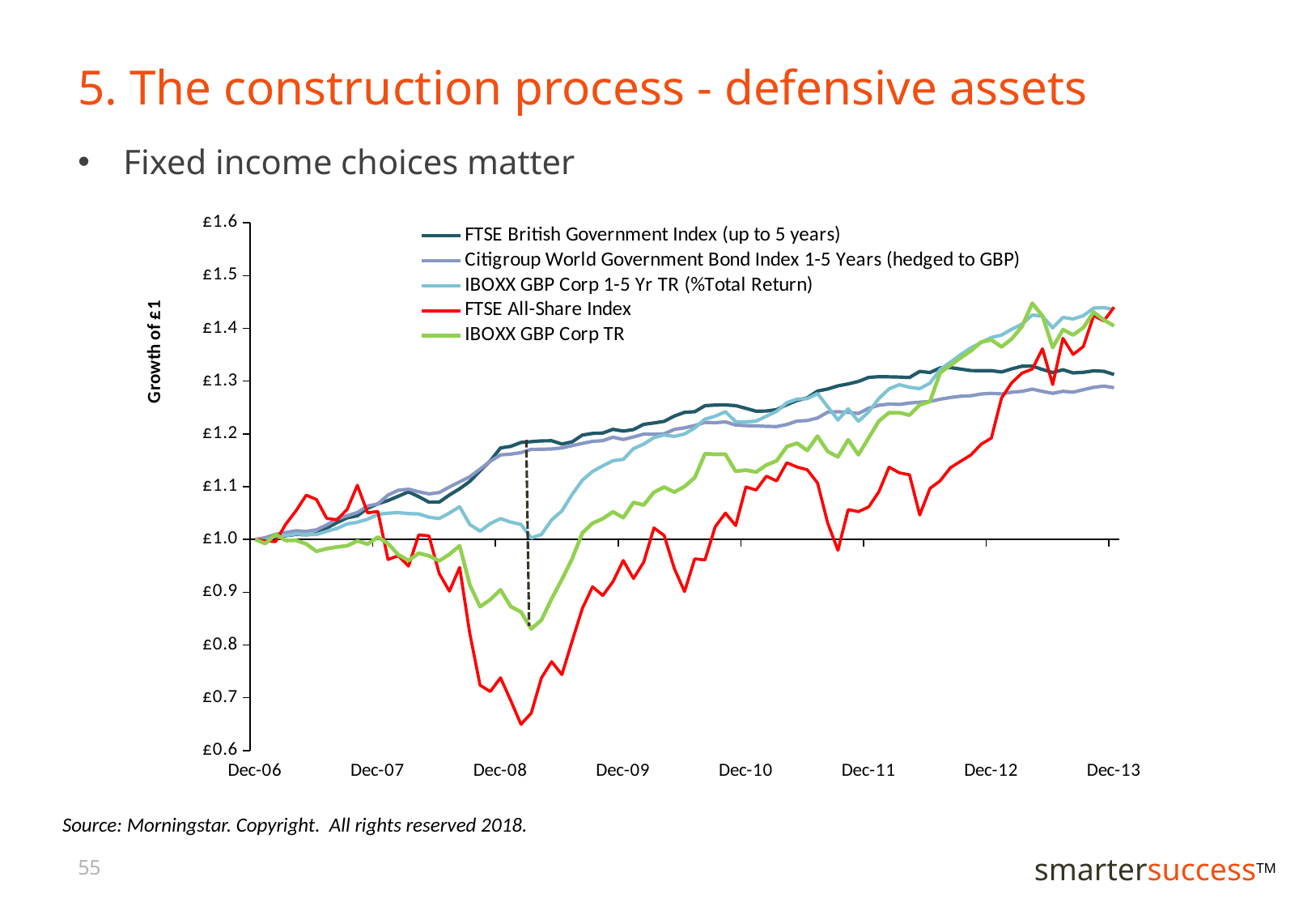
At Dec-10, which is higher: the FTSE British Government Index (up to 5 years) or the IBOXX GBP Corp TR? FTSE British Government Index (up to 5 years) Is the value of the Citigroup World Government Bond Index 1-5 Years (hedged to GBP) at Dec-08 greater or less than £1.1? greater Which series is drawn in red on the chart? FTSE All-Share Index Does the FTSE British Government Index (up to 5 years) rise or fall overall from Dec-06 to Dec-13? rise Is the value of the IBOXX GBP Corp TR series at Dec-13 greater or less than £1.3? greater Is the lowest value reached by the FTSE All-Share Index greater or less than £0.7? less What value do all the series start at in Dec-06? £1.0 What is the label on the vertical axis of the chart? Growth of £1 How many series does the chart legend list? 5 What type of chart is shown on the slide? line chart Which series falls to the lowest value at any point over the period shown? FTSE All-Share Index